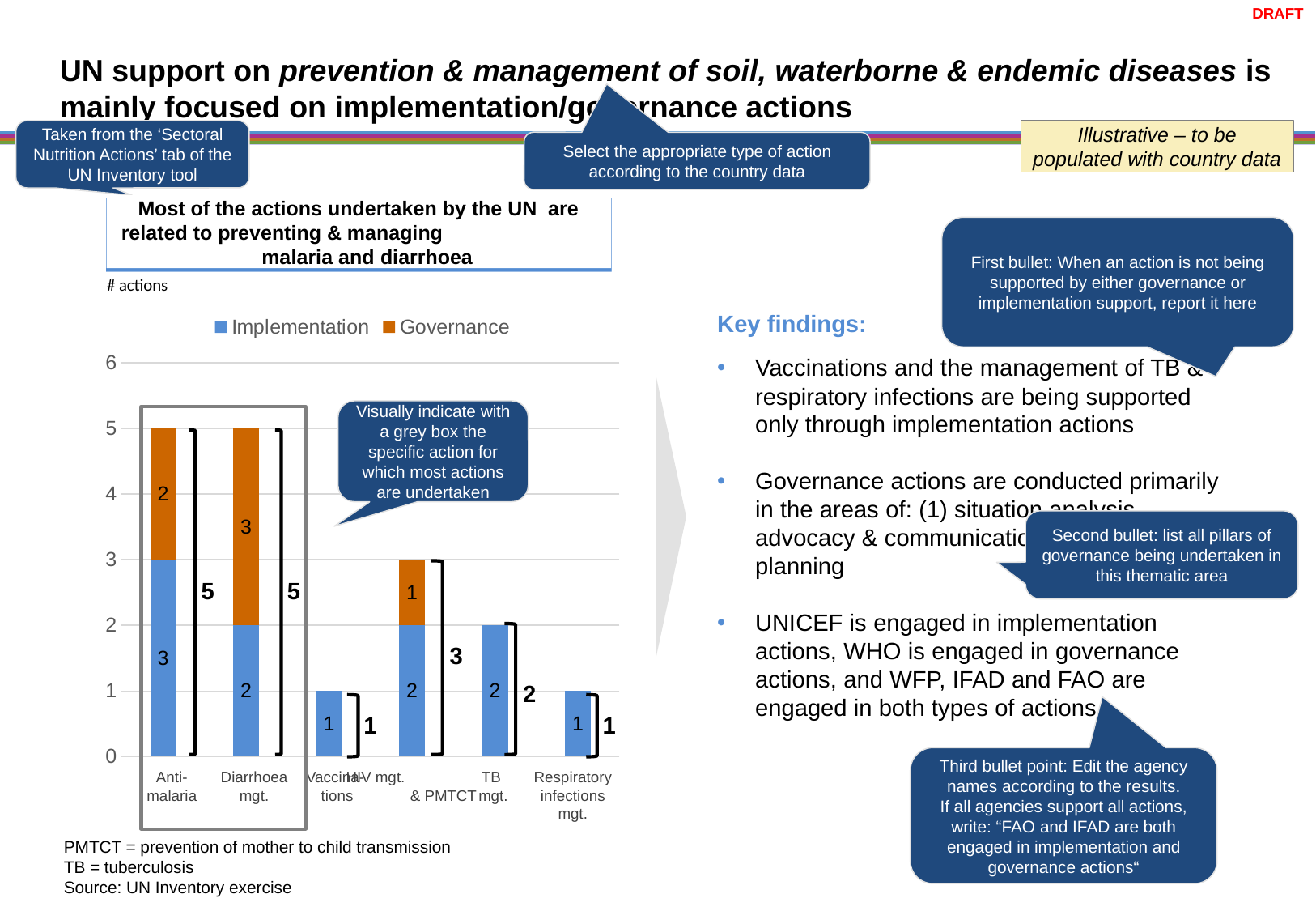
What is the Implementation value for Anti-malaria? 3 Which category has the highest Governance value? Diarrhoea mgt. What is the total number of actions for the TB mgt. bar? 2 What is the Governance value for Diarrhoea mgt.? 3 Which category has the lowest Implementation value, Vaccinations or TB mgt.? Vaccinations What is the Governance value for HIV mgt. & PMTCT? 1 What is the total number of actions for the HIV mgt. & PMTCT bar? 3 Which colour represents the Governance series in the chart? Orange How many categories are shown on the x axis of the chart? 6 How many series does the chart legend list? 2 What is the difference between the Implementation values for Anti-malaria and Diarrhoea mgt.? 1 What type of chart is shown on the slide? Stacked bar chart